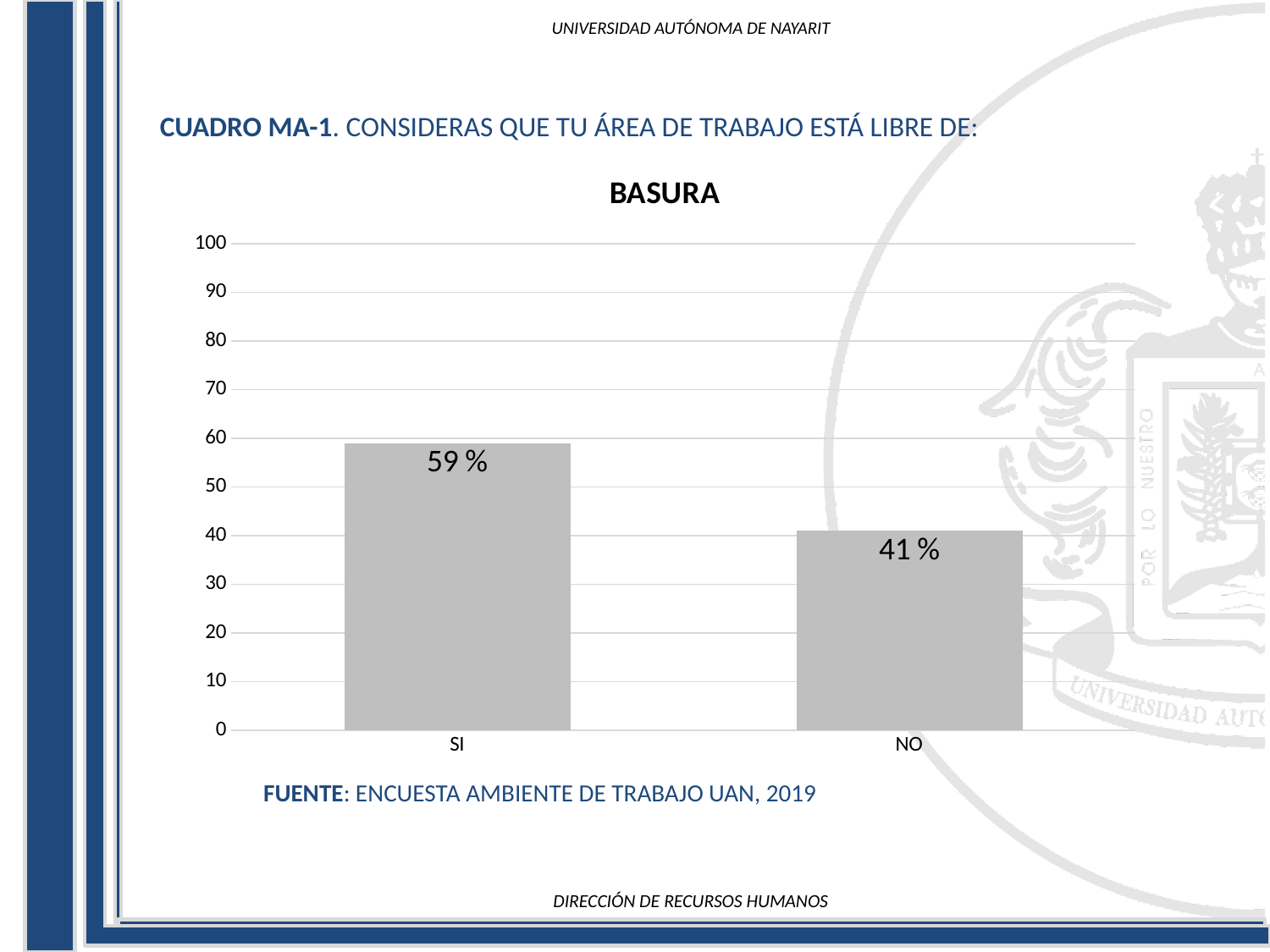
What kind of chart is shown? bar chart Which is larger, the value for SI or the value for NO? SI Which category has the lowest value? NO What is the value for NO? 41 % What is the maximum value shown on the y axis? 100 What is the title of the chart? BASURA What is the value for SI? 59 % Is the value for SI greater or less than 50? greater Which category has the highest value? SI How many categories are shown on the x axis? 2 Is the value for NO greater or less than 50? less What is the difference between the values for SI and NO? 18 %